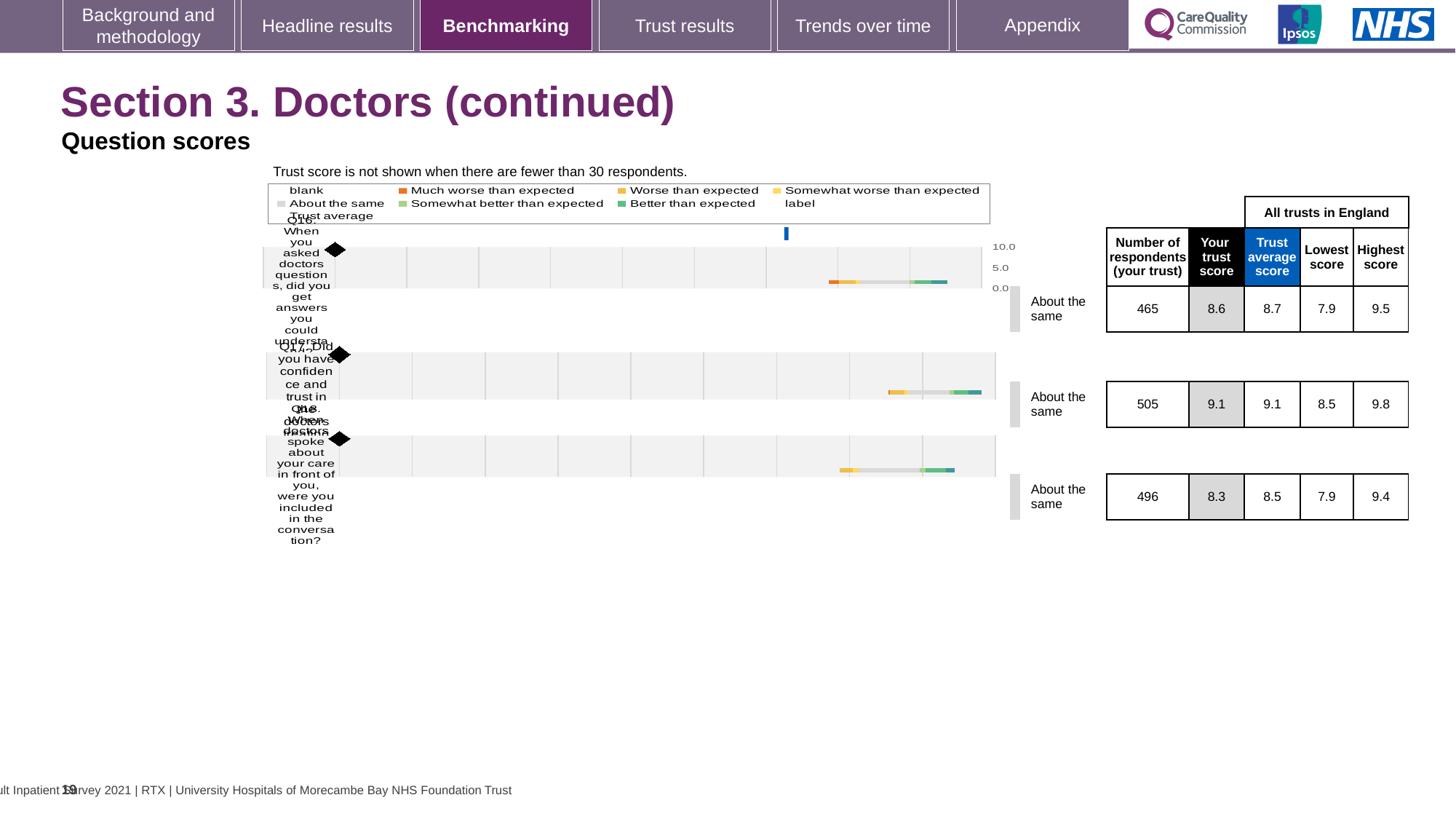
For Q18, what is the difference between the trust average score and your trust score? 0.2 What is the highest score across all trusts in England for Q18 (When doctors spoke about your care in front of you, were you included in the conversation?)? 9.4 What is the 'Your trust score' for Q17 (Did you have confidence and trust in the doctors treating you?)? 9.1 How many questions are shown in the chart? 3 What benchmark category is shown for Q17? About the same For Q18, which is larger: your trust score or the trust average score? Trust average score Which question has the highest 'Your trust score'? Q17 What is the lowest score across all trusts in England for Q17? 8.5 What kind of chart is used to show the question scores? Bar chart How many respondents from your trust answered Q16 (When you asked doctors questions, did you get answers you could understand?)? 465 For Q16, what is the difference between the highest score and the lowest score across all trusts in England? 1.6 Which question has the lowest 'Your trust score'? Q18